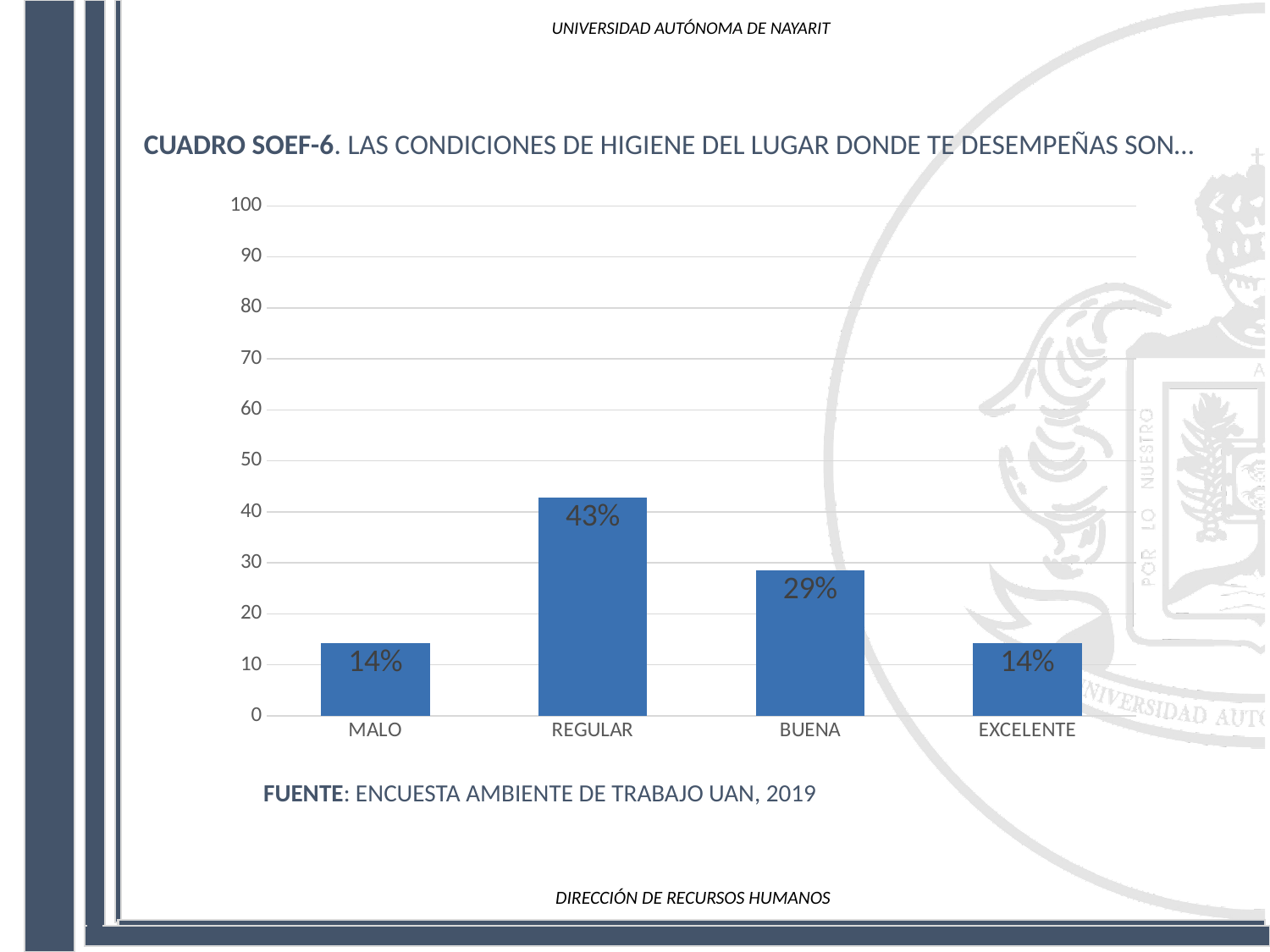
Is the value for REGULAR greater or less than 50? less What is the difference between the values for BUENA and EXCELENTE? 15% What is the value for BUENA? 29% What is the difference between the values for REGULAR and BUENA? 14% Which is larger, the value for BUENA or the value for EXCELENTE? BUENA What kind of chart is shown on the slide? bar chart What source is cited below the chart? ENCUESTA AMBIENTE DE TRABAJO UAN, 2019 How many categories are shown on the x axis? 4 What is the value for REGULAR? 43% Which category has the highest value? REGULAR What is the maximum value shown on the y axis? 100 What is the value for MALO? 14%